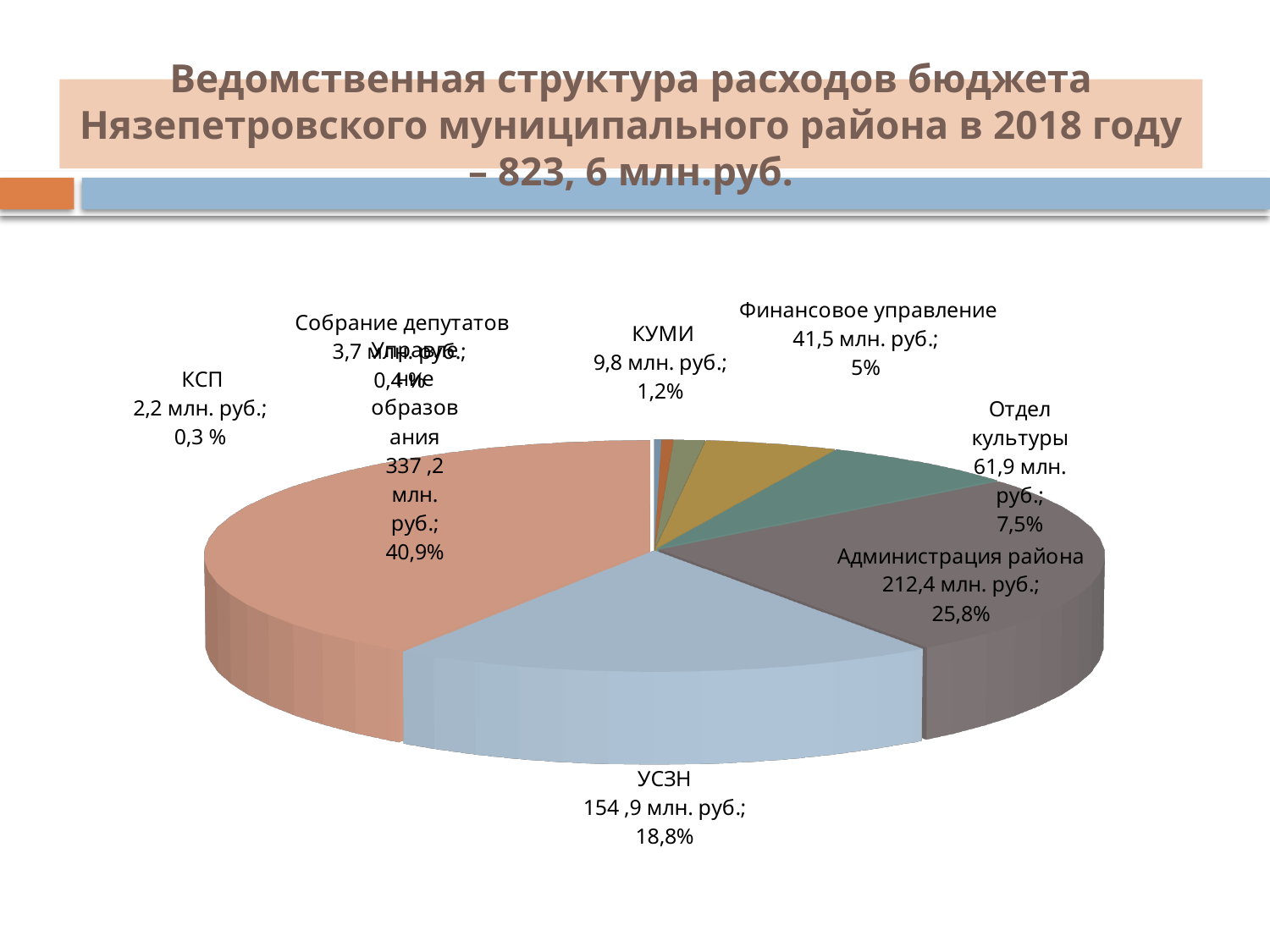
Which category has the largest slice of the pie? Управление образования How many categories (slices) does the pie chart show? 8 What is the value for Администрация района? 212,4 млн. руб. What is the value for КУМИ? 9,8 млн. руб. What is the difference between the values for Администрация района and УСЗН? 57,5 млн. руб. According to the slide title, what is the total budget expenditure of the Нязепетровский municipal district in 2018? 823, 6 млн.руб. What kind of chart is shown on the slide? Pie chart What share of the pie does УСЗН account for? 18,8% Which category has the smallest slice of the pie? КСП What share of the pie does Финансовое управление account for? 5% What share of the pie does Отдел культуры account for? 7,5% Which is larger, the value for Отдел культуры or the value for Финансовое управление? Отдел культуры